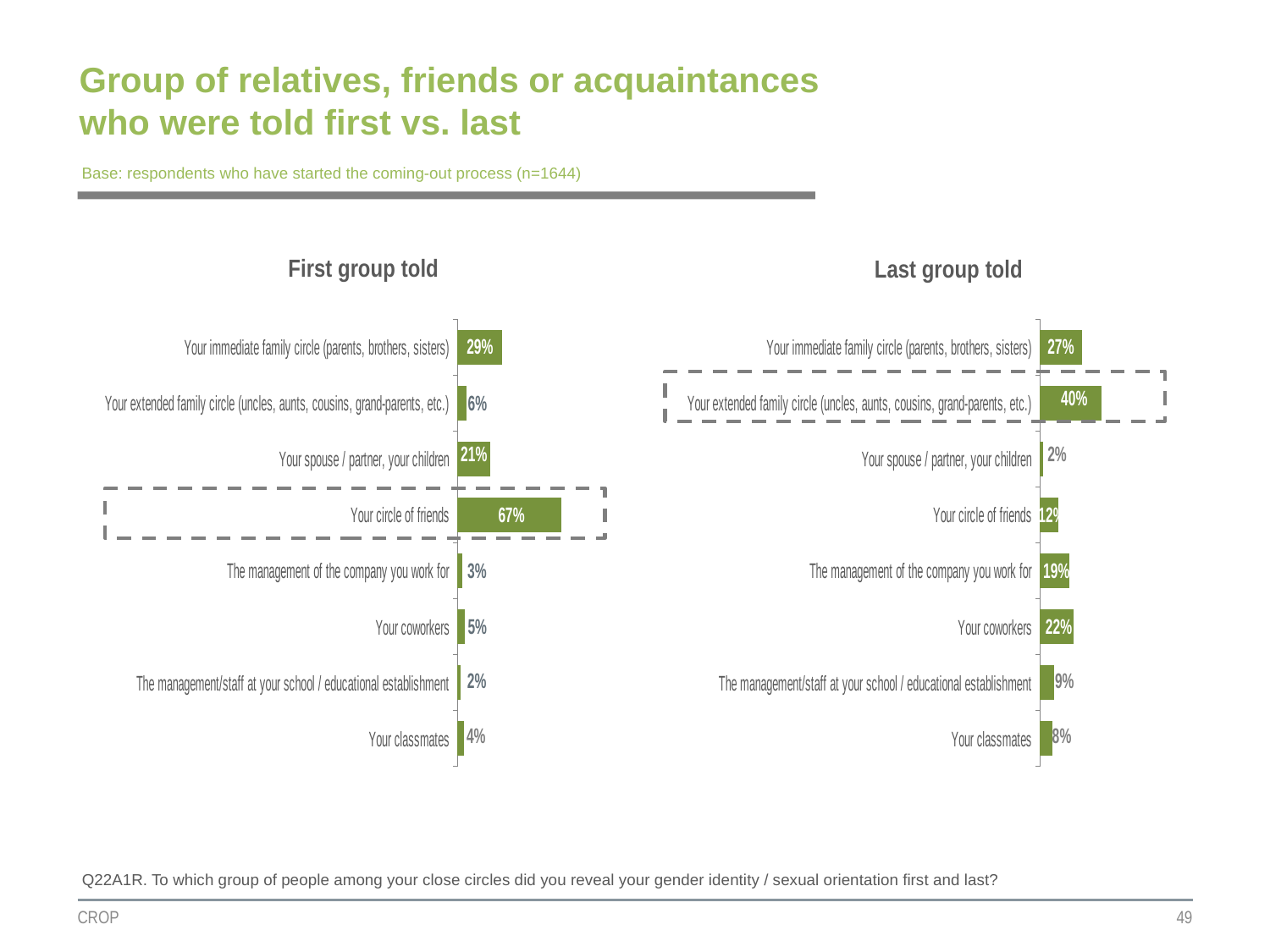
In the "First group told" chart, what is the value for Your spouse / partner, your children? 21% In the "First group told" chart, which is larger: Your immediate family circle or Your spouse / partner, your children? Your immediate family circle (parents, brothers, sisters) What kind of chart is the "First group told" chart? Bar chart In the "Last group told" chart, what is the difference between Your coworkers and The management of the company you work for? 3% In the "Last group told" chart, which category has the lowest value? Your spouse / partner, your children In the "First group told" chart, what is the value for Your circle of friends? 67% How many categories are shown in the "Last group told" chart? 8 In the "First group told" chart, which category has the highest value? Your circle of friends In the "Last group told" chart, what is the value for Your coworkers? 22% In the "Last group told" chart, what is the value for Your extended family circle (uncles, aunts, cousins, grand-parents, etc.)? 40% In the "First group told" chart, which category has the lowest value? The management/staff at your school / educational establishment In the "Last group told" chart, what is the difference between Your extended family circle and Your immediate family circle? 13%